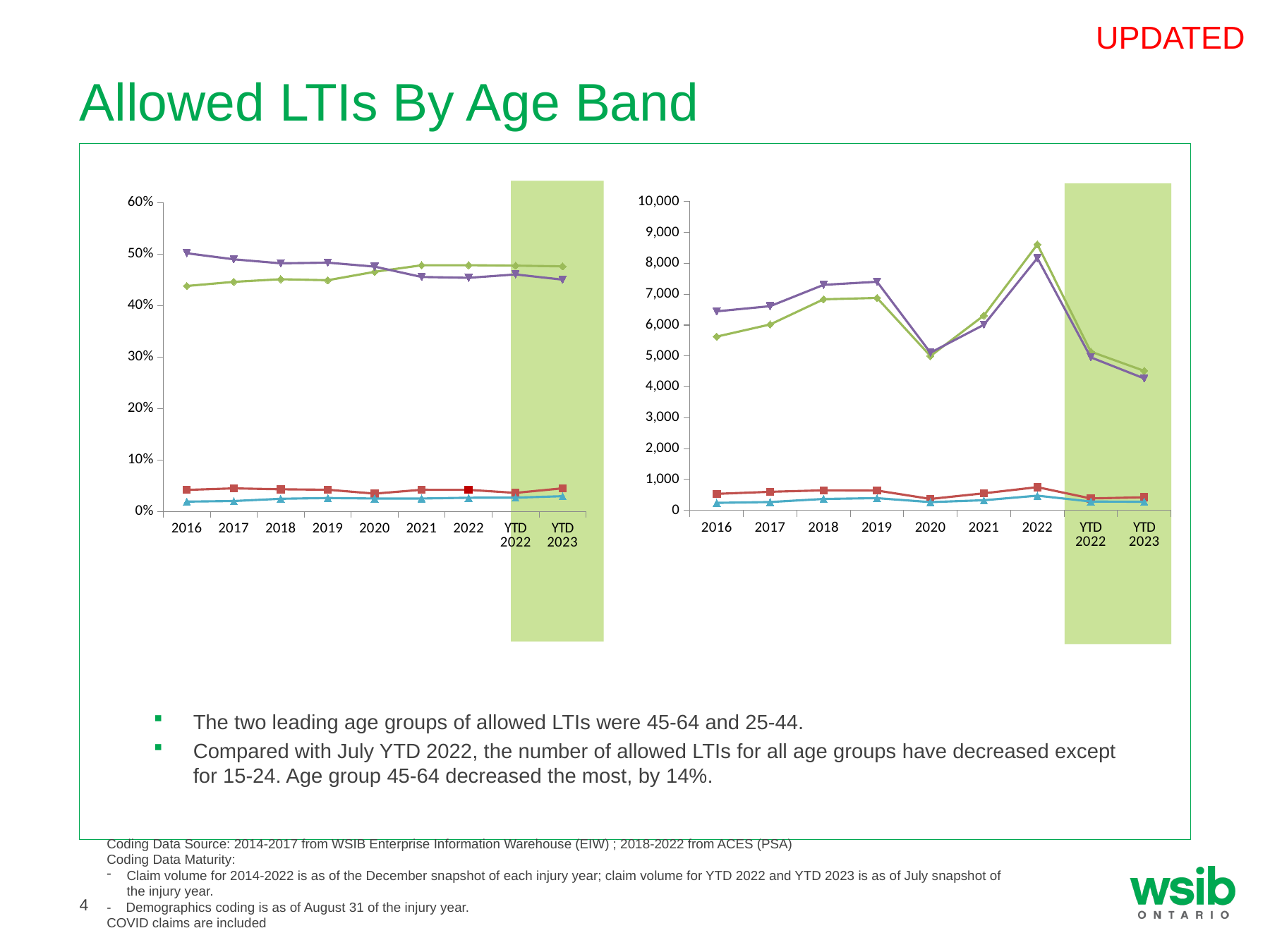
In the left chart, is the value of the green line at 2016 greater or less than 50%? less In the right chart, is the value of the red line at 2022 greater or less than 1,000? less In the right chart, is the value of the green line at 2016 greater or less than 5,000? greater What is the highest value shown on the y axis of the left chart? 60% How many lines are plotted in the right chart? 4 How many categories are shown on the x axis of the left chart? 9 What kind of chart is the left chart on the slide? line chart What is the highest value shown on the y axis of the right chart? 10,000 What kind of chart is the right chart on the slide? line chart In the right chart, does the purple line rise or fall from 2016 to 2019? rise How many categories are shown on the x axis of the right chart? 9